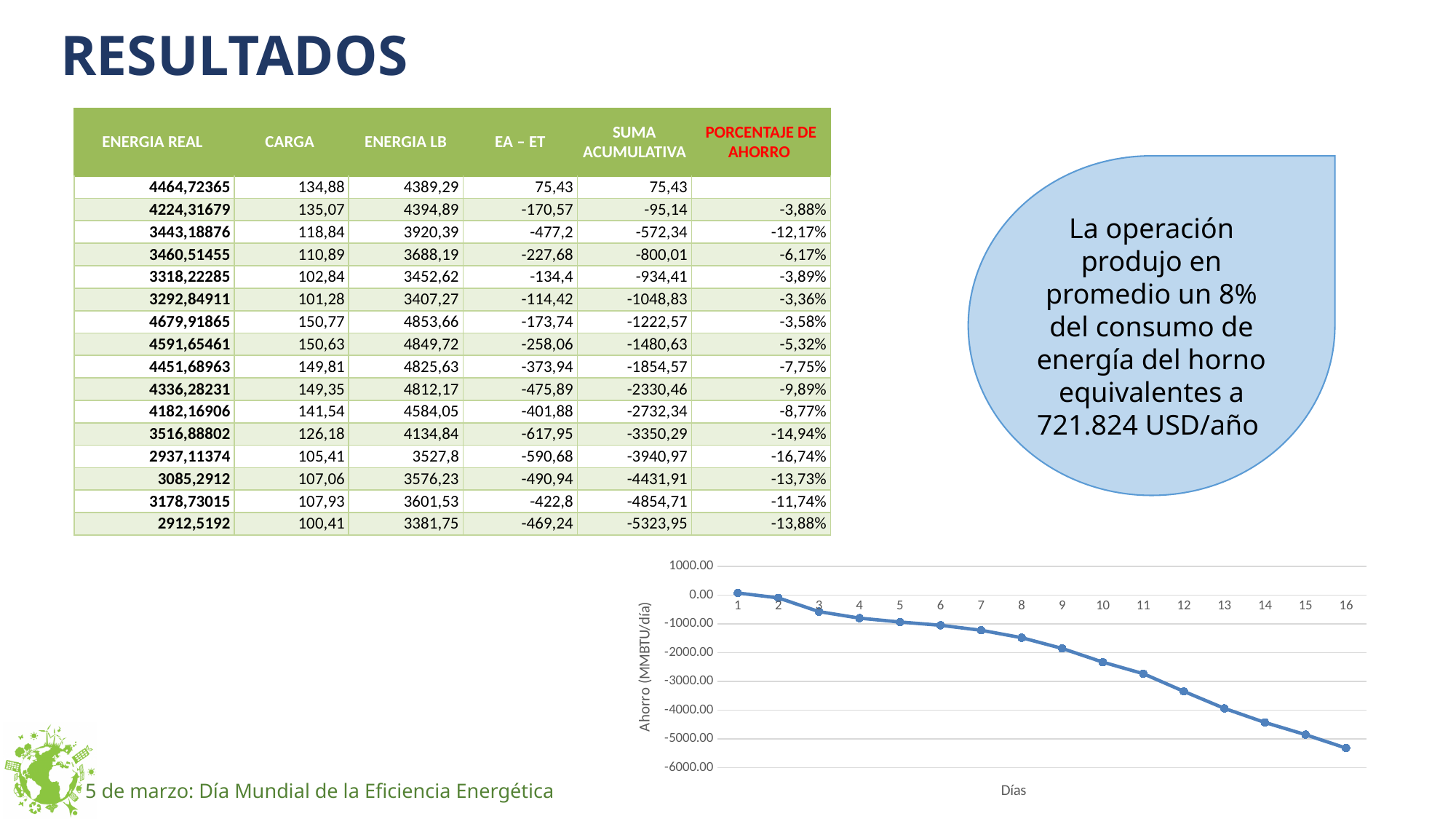
What is the title of the vertical axis of the line chart? Ahorro (MMBTU/día) In the line chart, is the value for day 8 greater or less than -1000.00? less In the line chart, is the value for day 16 greater or less than -5000.00? less Which day has the lowest value in the line chart? 16 In the line chart, is the value for day 10 greater or less than -2000.00? less How many days (points) are plotted on the x axis of the line chart? 16 Do the values in the line chart rise or fall as the days increase along the x axis? fall In the line chart, which has the larger value, day 4 or day 12? day 4 What kind of chart is shown at the bottom right of the slide? line chart Which day has the highest value in the line chart? 1